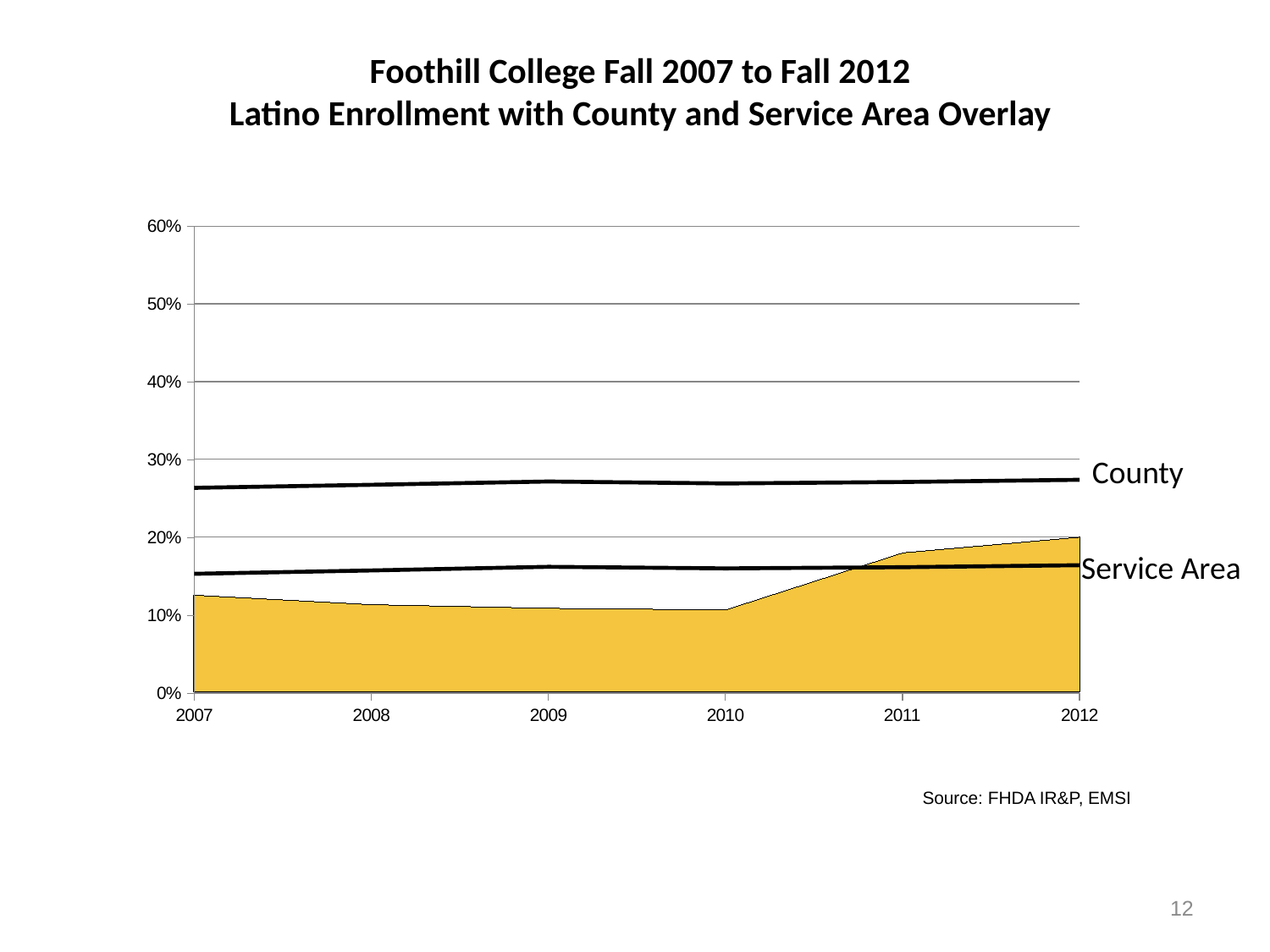
Is the Service Area value in 2012 greater or less than 20%? less Is the Foothill College (yellow area) value in 2010 greater or less than 20%? less Is the County value in 2012 greater or less than 30%? less How many years are shown on the x axis? 6 Which two lines are labelled on the right side of the chart? County and Service Area What kind of chart is used for the yellow Foothill College enrollment series? area chart In 2009, which is larger, the County value or the Service Area value? County In 2012, which is larger, the Foothill College (yellow area) value or the Service Area value? Foothill College Does the Foothill College (yellow area) value rise or fall from 2010 to 2012? rise What is the source cited below the chart? FHDA IR&P, EMSI